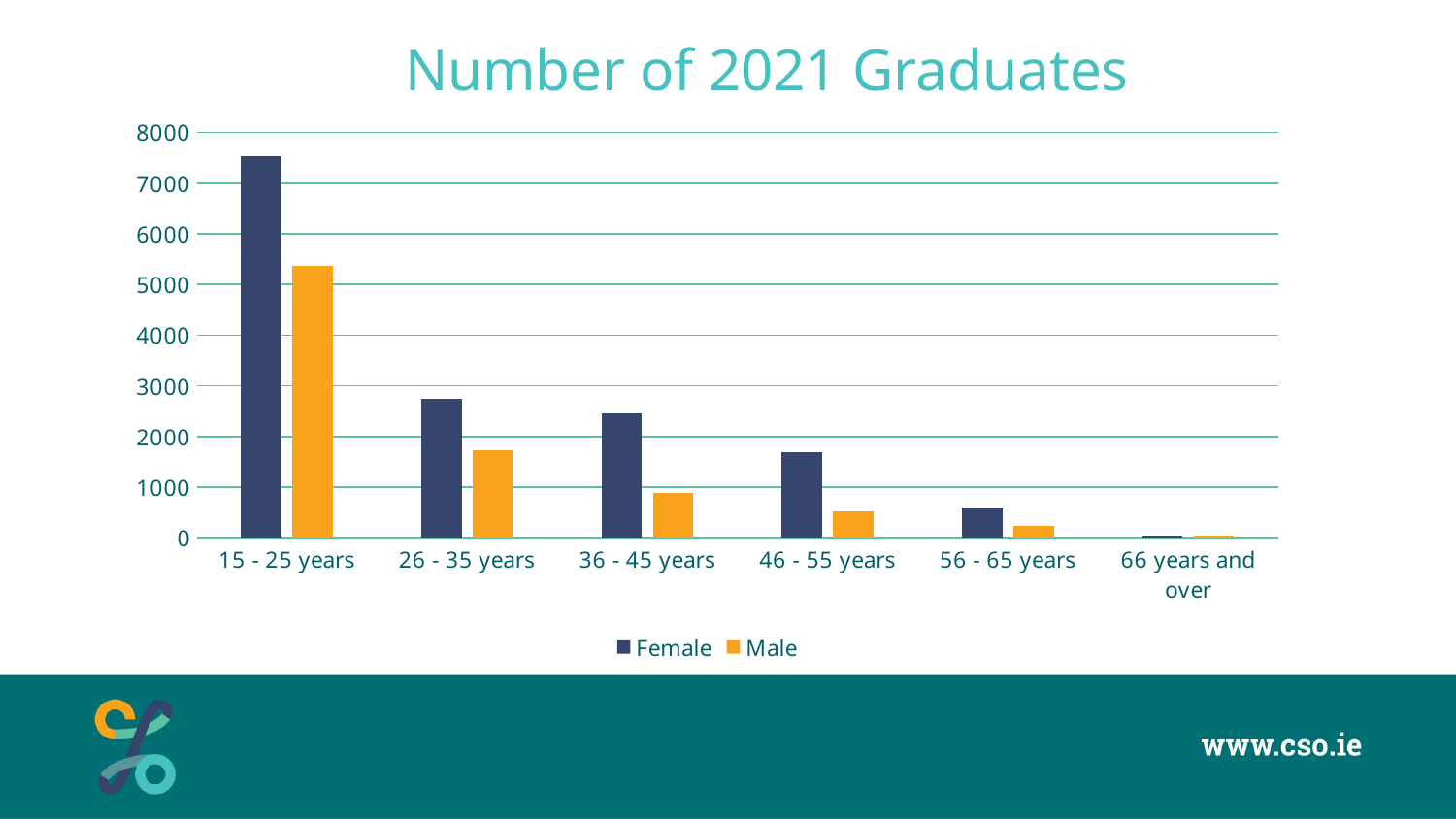
Is the value for Female graduates aged 26 - 35 years greater or less than 3000? less In the 46 - 55 years category, which is larger, the Female or the Male value? Female Do the Female values rise or fall as the age categories move from left to right along the x axis? fall What is the title of the chart? Number of 2021 Graduates Is the value for Female graduates aged 15 - 25 years greater or less than 7000? greater How many series does the legend list? 2 Is the value for Male graduates aged 15 - 25 years greater or less than 5000? greater What type of chart is shown on the slide? bar chart Which age category has the lowest number of Male graduates? 66 years and over Which age category has the highest number of Female graduates? 15 - 25 years How many age categories are shown on the x axis? 6